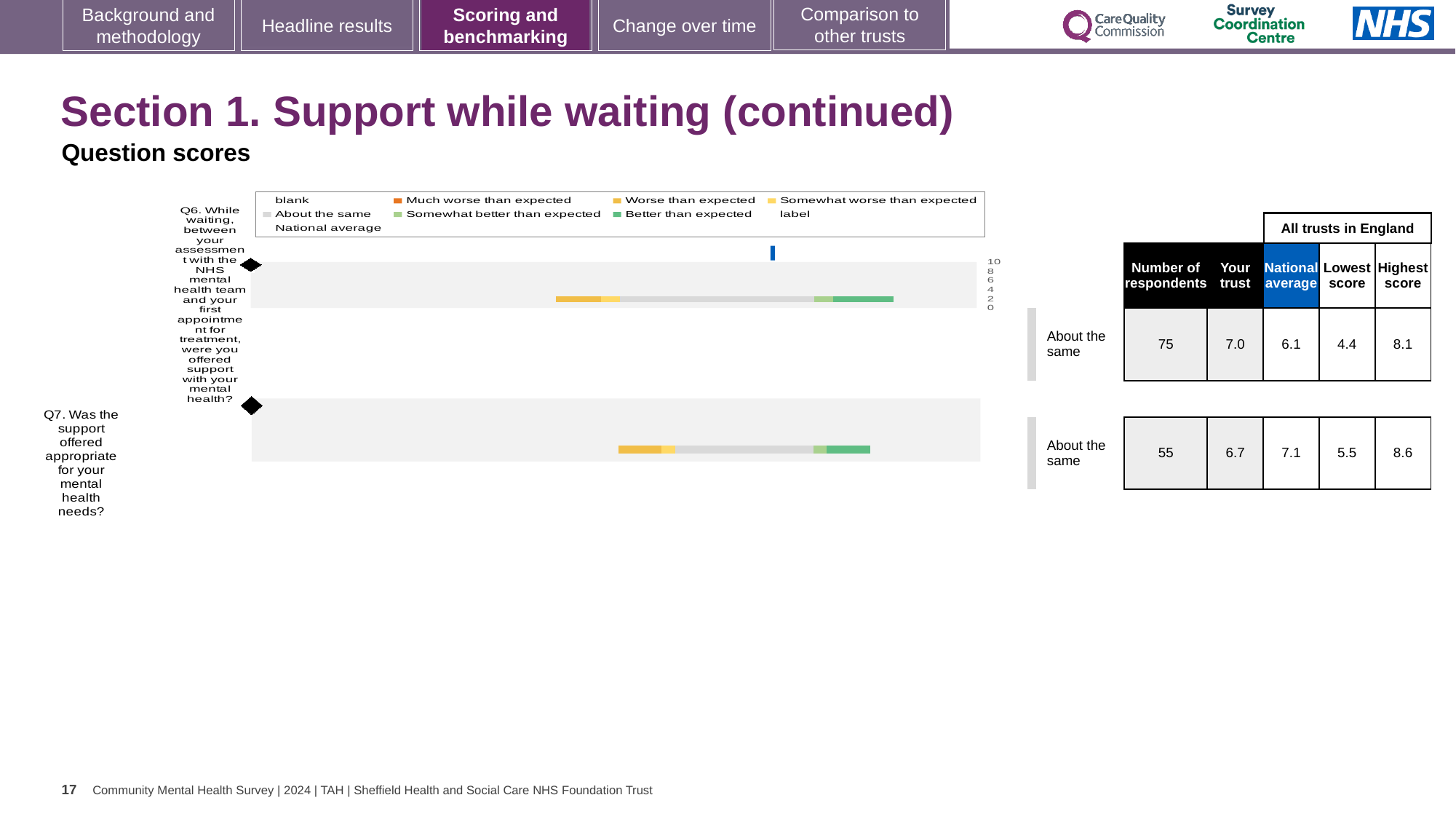
Which question has more respondents, Q6 or Q7? Q6 What kind of chart is used to show the question scores? Bar chart How many more respondents answered Q6 than Q7? 20 What is the difference between the highest score and the lowest score for Q7? 3.1 What is the 'Your trust' score for Q7 (was the support offered appropriate for your mental health needs)? 6.7 How many questions are plotted on the chart? 2 What benchmark category is given for Q7? About the same What is the highest score among all trusts in England for Q7? 8.6 How many respondents are shown for Q6 (support while waiting between assessment and first appointment)? 75 What is the lowest score among all trusts in England for Q6? 4.4 For Q6, which is higher: the 'Your trust' score or the national average? Your trust What is the national average score for Q6? 6.1